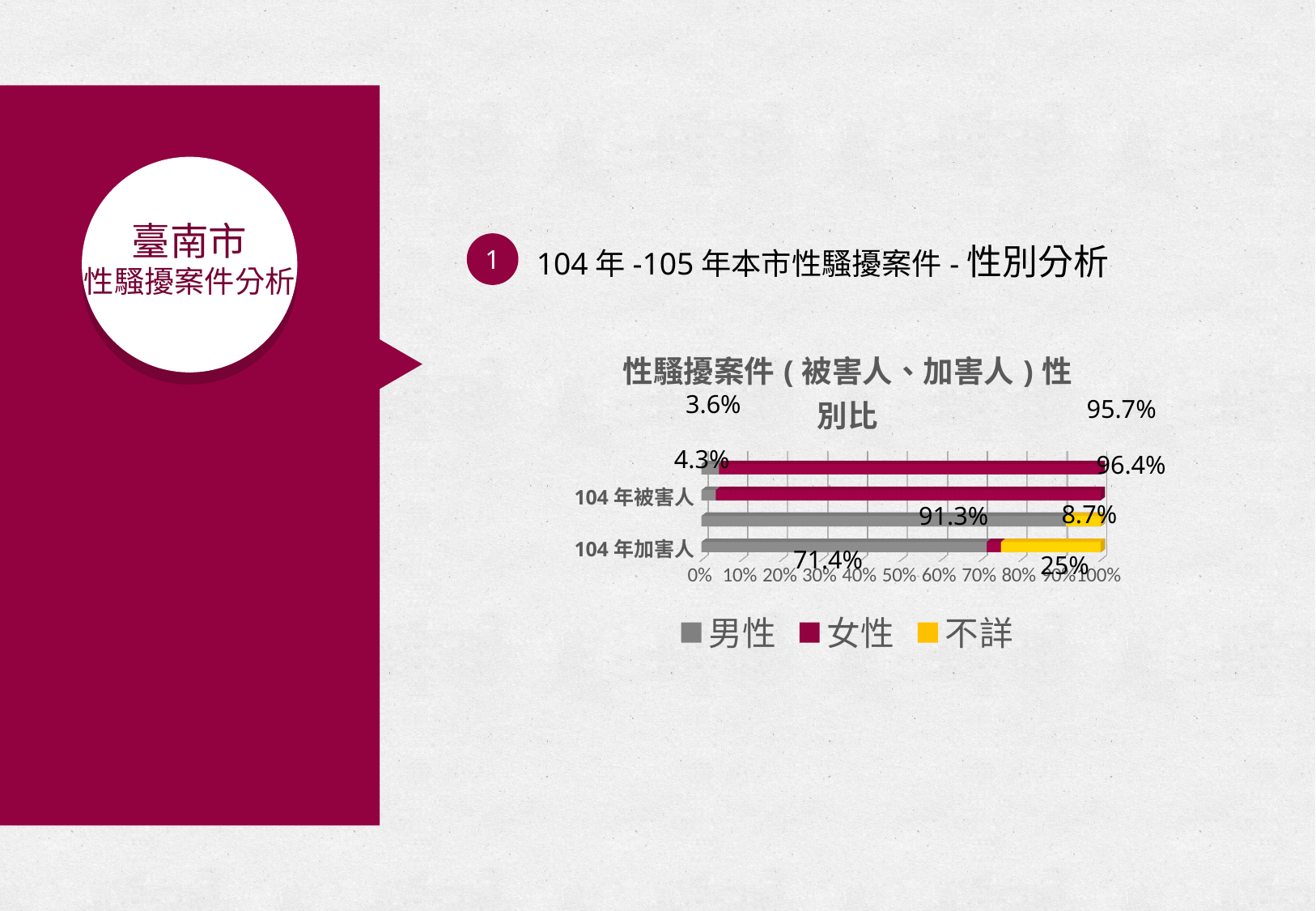
What are the three series named in the legend? 男性, 女性, 不詳 How many bars are plotted in the chart? 4 How many series does the chart legend list? 3 What is the 不詳 share for 104 年加害人? 25% Is the 女性 share for 104 年被害人 greater or less than 90%? greater What type of chart is shown on the slide? Stacked bar chart For 104 年加害人, what is the difference between the 男性 share and the 不詳 share? 46.4 percentage points Which has the larger 男性 share, 104 年被害人 or 104 年加害人? 104 年加害人 What is the 男性 share for 104 年加害人? 71.4% For 104 年加害人, which series has the largest share? 男性 What is the title of the chart? 性騷擾案件（被害人、加害人）性別比 Is the 男性 share for 104 年被害人 greater or less than 10%? less